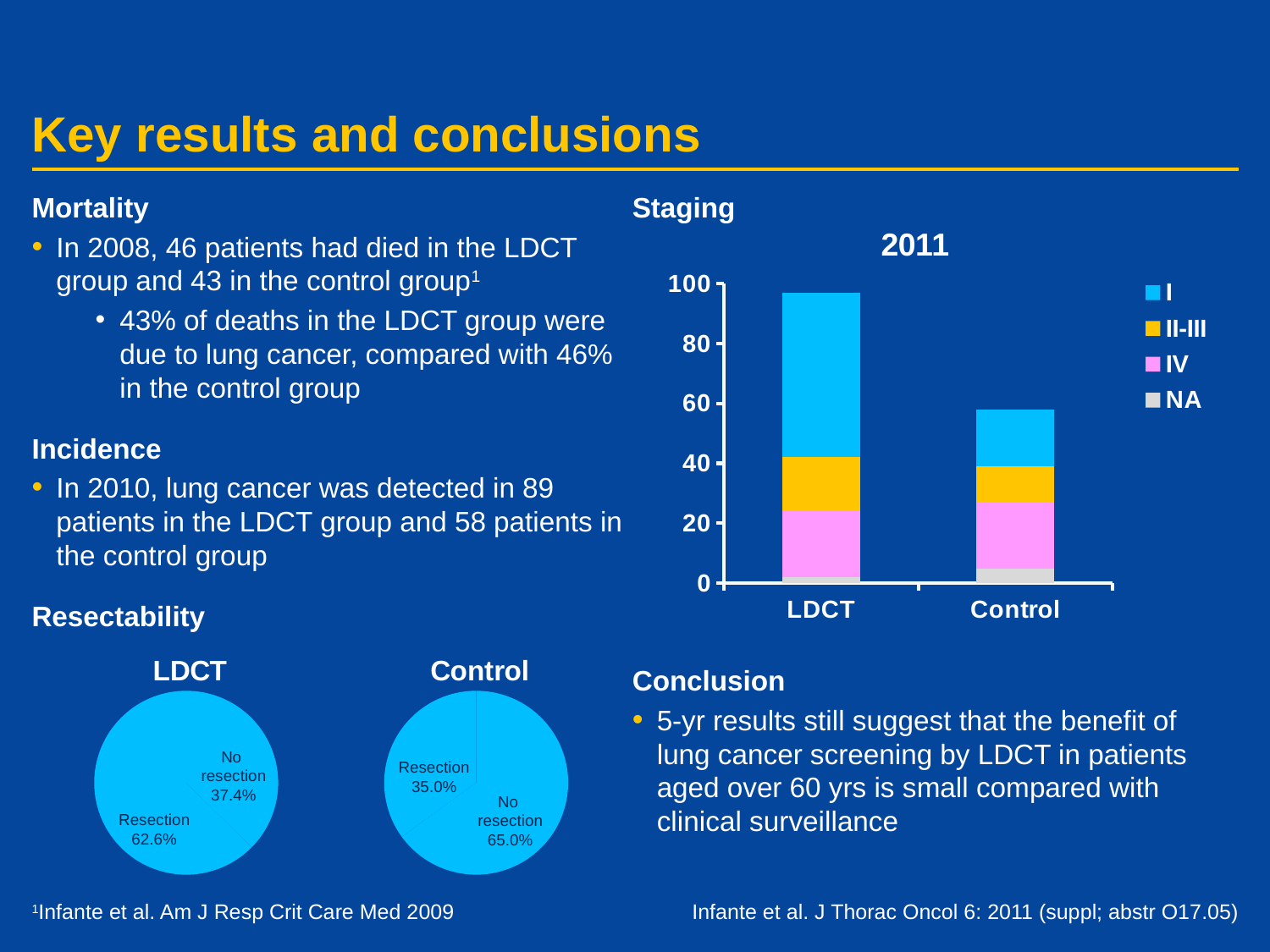
In the '2011' staging chart, is the total height of the Control bar greater or less than 40? greater In the Control resectability pie chart, which slice is larger, Resection or No resection? No resection In the '2011' staging chart, which group has the taller stacked bar, LDCT or Control? LDCT In the LDCT resectability pie chart, what share of patients had no resection? 37.4% In the '2011' staging chart, is the total height of the LDCT bar greater or less than 80? greater In the LDCT resectability pie chart, what share of patients had resection? 62.6% In the LDCT resectability pie chart, what is the difference in percentage points between the Resection and No resection slices? 25.2 In the '2011' staging chart, how many categories are shown on the x axis? 2 In the '2011' staging chart, which legend entry is shown in yellow? II-III In the Control resectability pie chart, what share of patients had resection? 35.0% What kind of chart is the '2011' staging chart? Bar chart In the '2011' staging chart, how many series does the legend list? 4